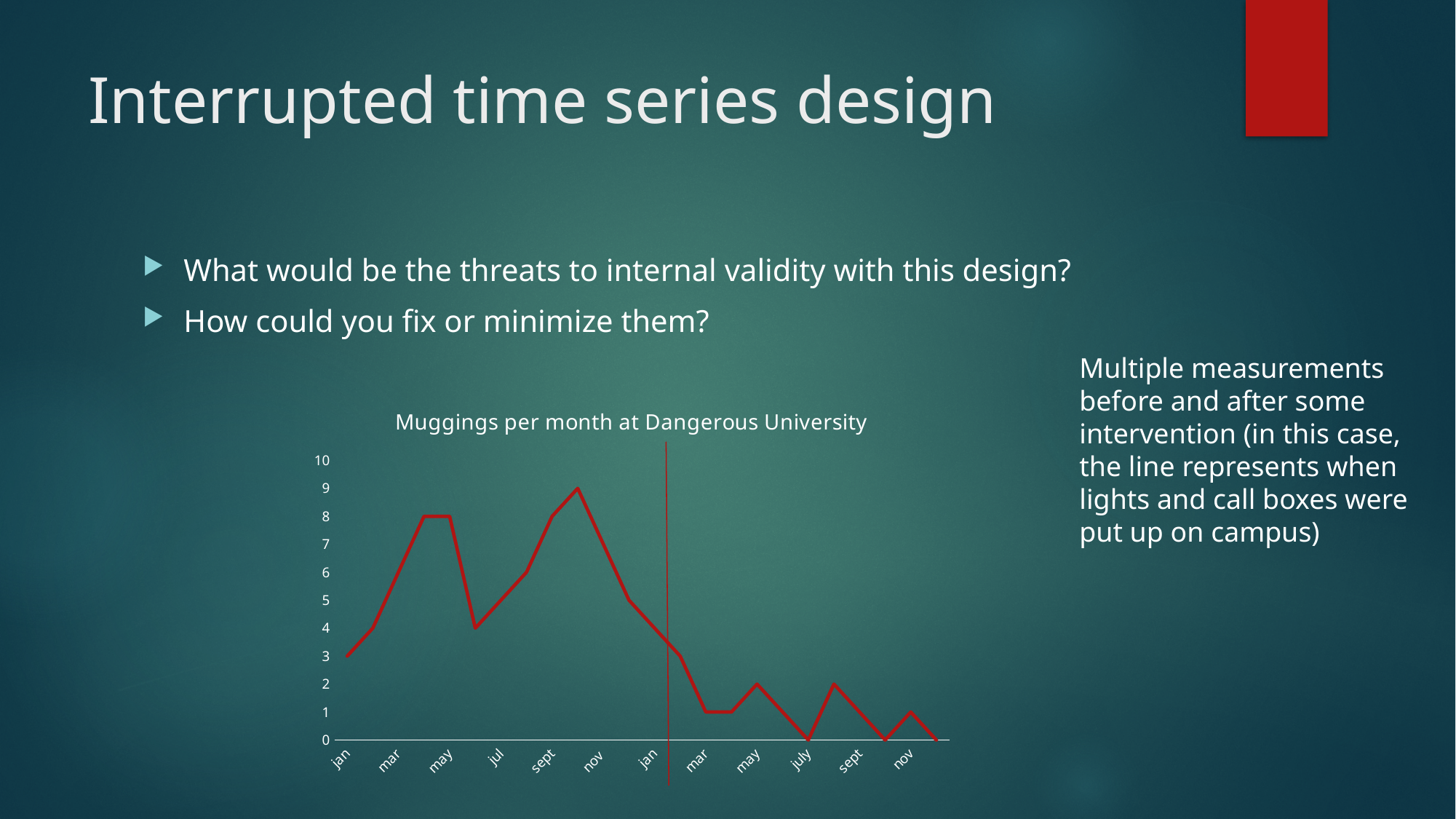
What is the highest value the line reaches on the chart? 9 What colour is the plotted line on the chart? red How many month labels are shown along the x axis of the chart? 12 Is the value for the first jan greater or less than 5? less Is the value for the second nov greater or less than 3? less Which is larger, the value for the first may or the value for the second may? the first may What is the lowest value the line reaches on the chart? 0 What kind of chart is shown on the slide? line chart Do the values generally rise or fall after the vertical line marking the intervention? fall Is the value for the first may greater or less than 6? greater What is the title of the chart? Muggings per month at Dangerous University